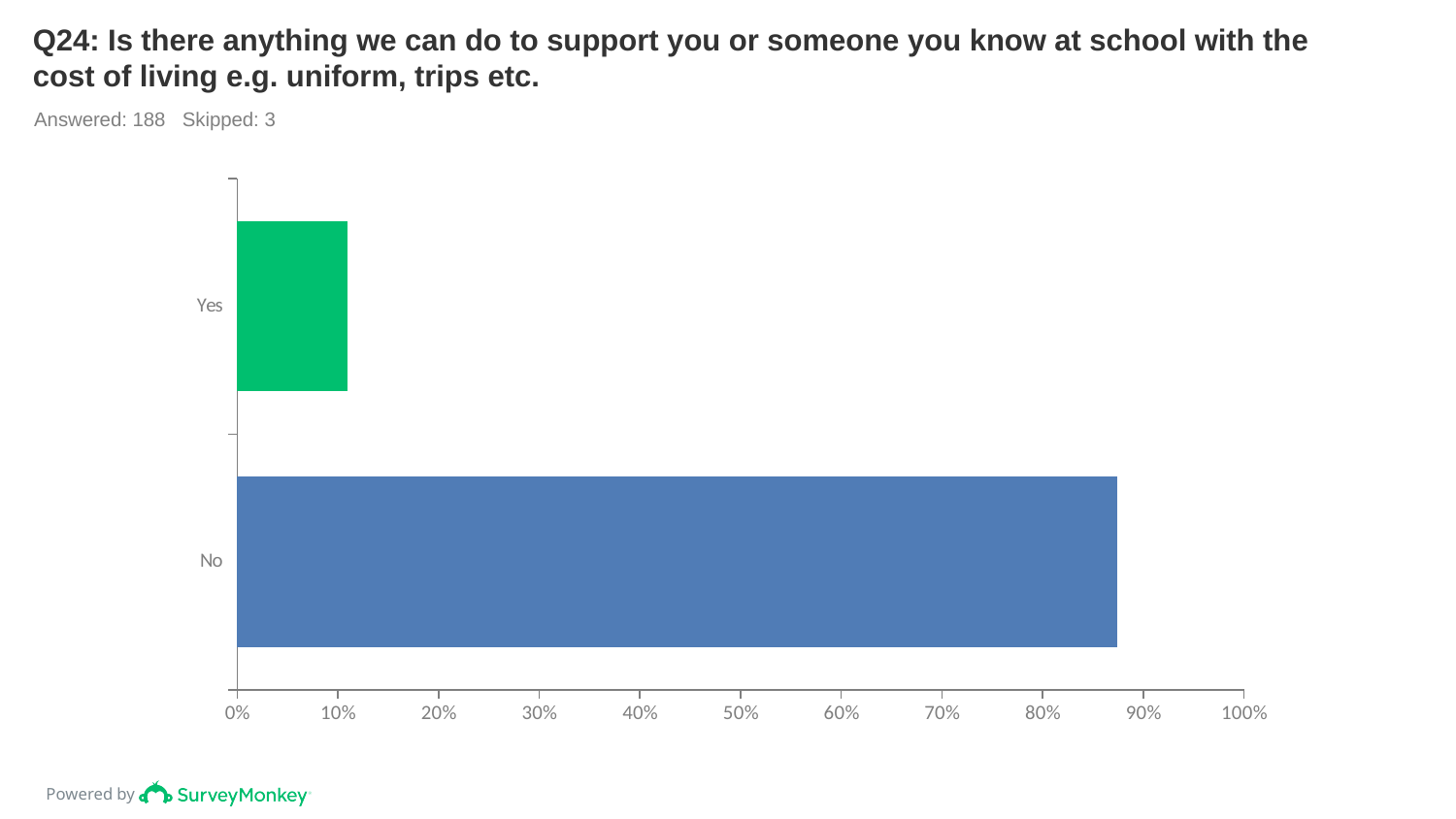
How many categories are plotted in the chart? 2 Is the value for No greater or less than 90%? less How many respondents answered this question according to the slide? 188 Which category has the highest value? No Which is larger, the value for Yes or the value for No? No What is the maximum value shown on the x axis? 100% Is the value for No greater or less than 80%? greater What kind of chart is shown on the slide? bar chart Is the value for Yes greater or less than 20%? less Which category has the lowest value? Yes